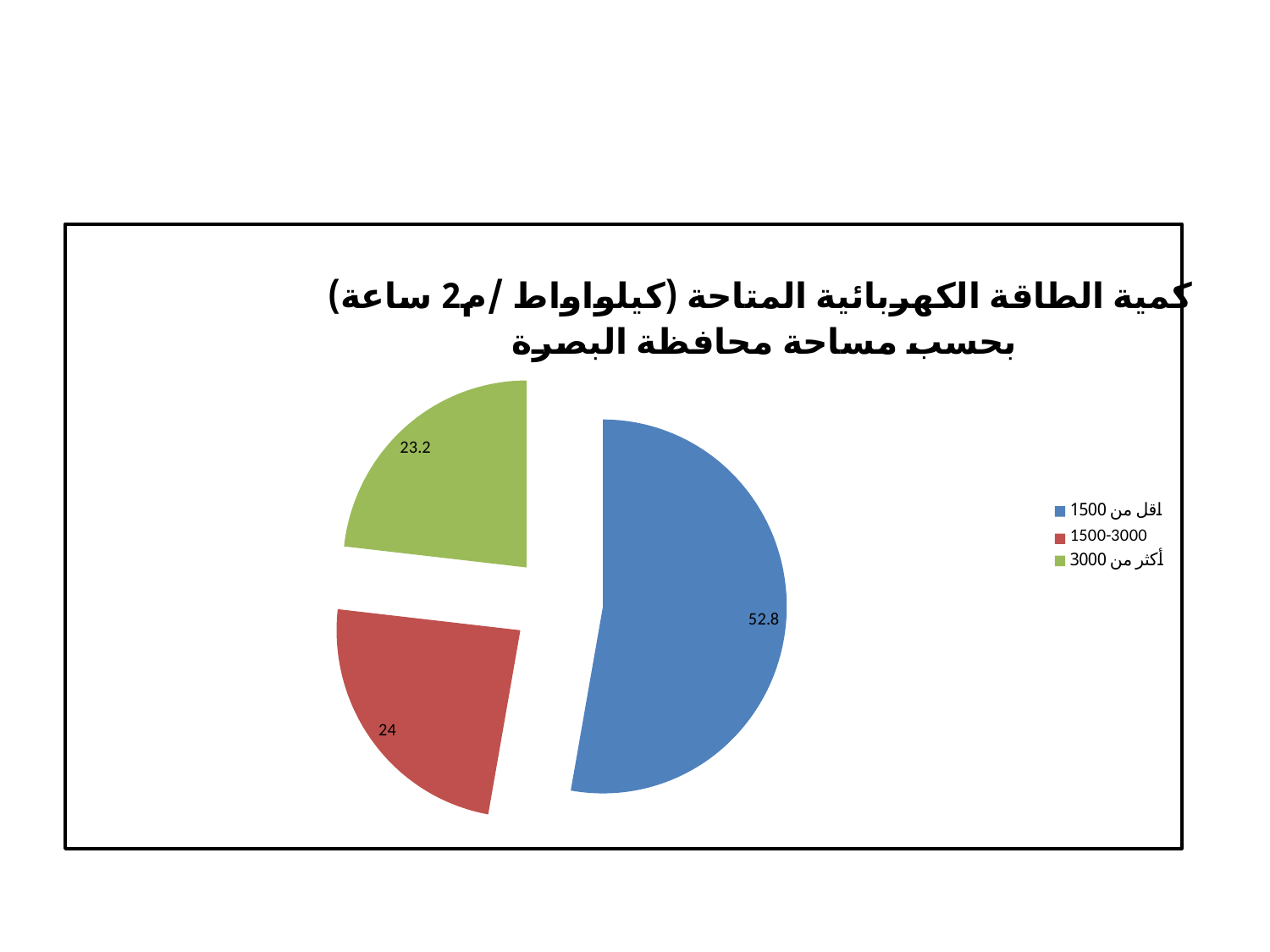
What is the difference between the values for "اقل من 1500" and "1500-3000"? 28.8 What is the difference between the values for "1500-3000" and "أكثر من 3000"? 0.8 What is the value for the "أكثر من 3000" slice? 23.2 Which category has the smallest slice of the pie? أكثر من 3000 What kind of chart is shown on the slide? pie chart How many slices does the pie chart have? 3 Which is larger, the value for "اقل من 1500" or the value for "أكثر من 3000"? اقل من 1500 What is the value for the "اقل من 1500" slice? 52.8 How many entries does the legend list? 3 Which category has the largest slice of the pie? اقل من 1500 What is the value for the "1500-3000" slice? 24 What colour is the "1500-3000" slice? red